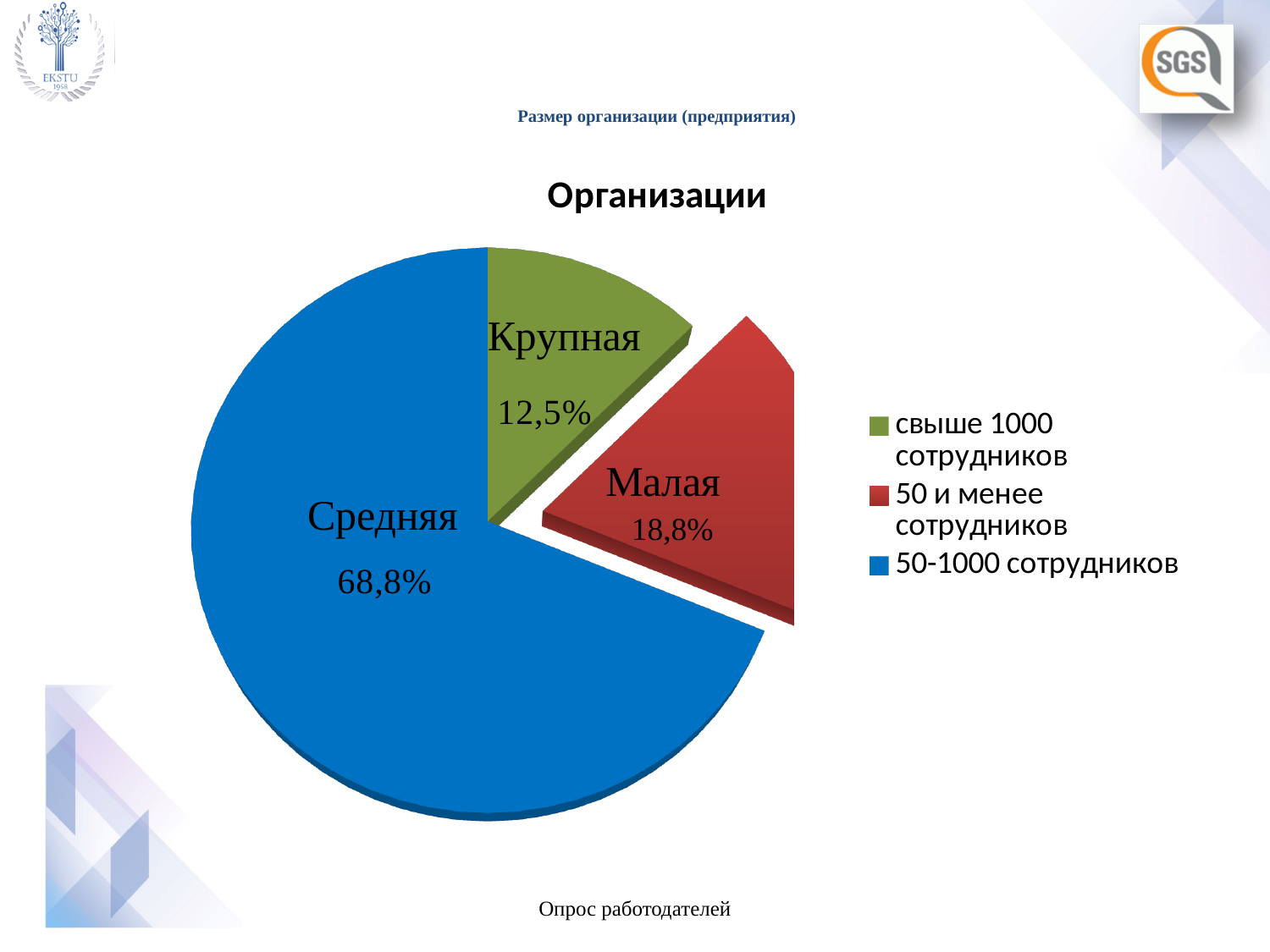
What kind of chart is shown on the slide? Pie chart What is the title of the chart? Организации Which is larger, the Малая slice or the Крупная slice? Малая What share of the pie does the Средняя slice represent? 68,8% Which slice of the pie is the smallest? Крупная What is the difference in percentage points between the Средняя slice and the Малая slice? 50 percentage points How many slices does the pie chart have? 3 What share of the pie does the Малая slice represent? 18,8% Which legend entry corresponds to the blue slice? 50-1000 сотрудников What is the difference in percentage points between the Малая slice and the Крупная slice? 6,3 percentage points Which slice of the pie is the largest? Средняя What share of the pie does the Крупная slice represent? 12,5%